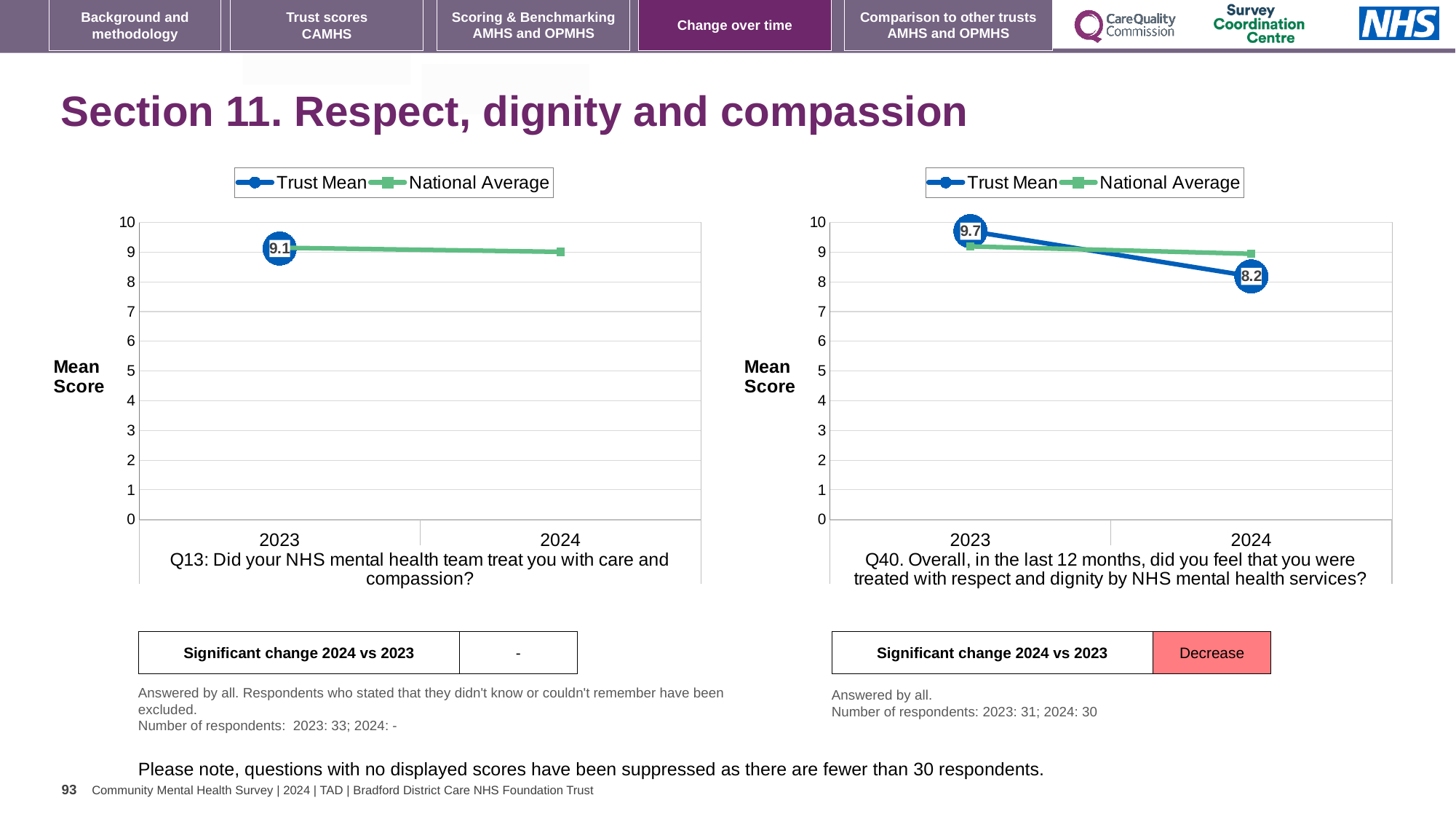
What kind of chart is the left chart (Q13)? line chart How many series does the legend of the right chart (Q40) list? 2 In the right chart (Q40), what is the difference between the Trust Mean in 2023 and in 2024? 1.5 In the left chart (Q13), what is the Trust Mean value for 2023? 9.1 In the right chart (Q40), does the Trust Mean rise or fall from 2023 to 2024? fall In the left chart (Q13), is the National Average value for 2023 greater or less than 8? greater How many years are shown on the x axis of the left chart (Q13)? 2 In the right chart (Q40), what is the Trust Mean value for 2023? 9.7 What are the two series named in the legend of the left chart (Q13)? Trust Mean and National Average In the right chart (Q40), what is the Trust Mean value for 2024? 8.2 In the right chart (Q40), is the Trust Mean higher in 2023 or in 2024? 2023 In the right chart (Q40), is the National Average value for 2024 greater or less than 8? greater